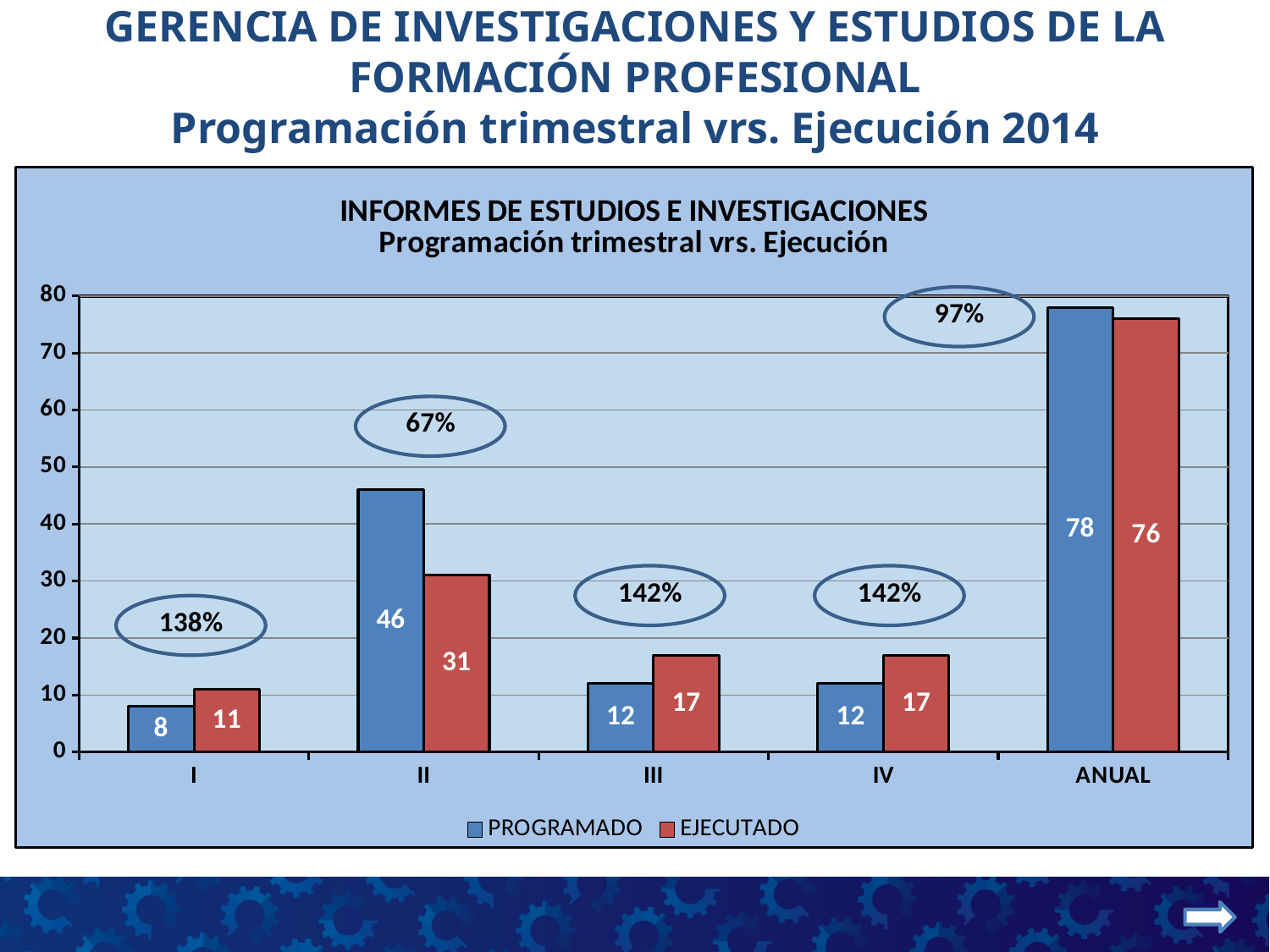
How many series does the legend list? 2 What is the difference between PROGRAMADO and EJECUTADO for quarter II? 15 Which category has the highest PROGRAMADO value? ANUAL Which is larger for quarter III, PROGRAMADO or EJECUTADO? EJECUTADO Is the PROGRAMADO value for ANUAL greater or less than 70? greater Which category has the lowest EJECUTADO value? I How many categories are shown on the x axis? 5 What is the EJECUTADO value for ANUAL? 76 What kind of chart is shown? bar chart What is the EJECUTADO value for quarter I? 11 What percentage is shown in the circle above quarter IV? 142% What is the PROGRAMADO value for quarter II? 46